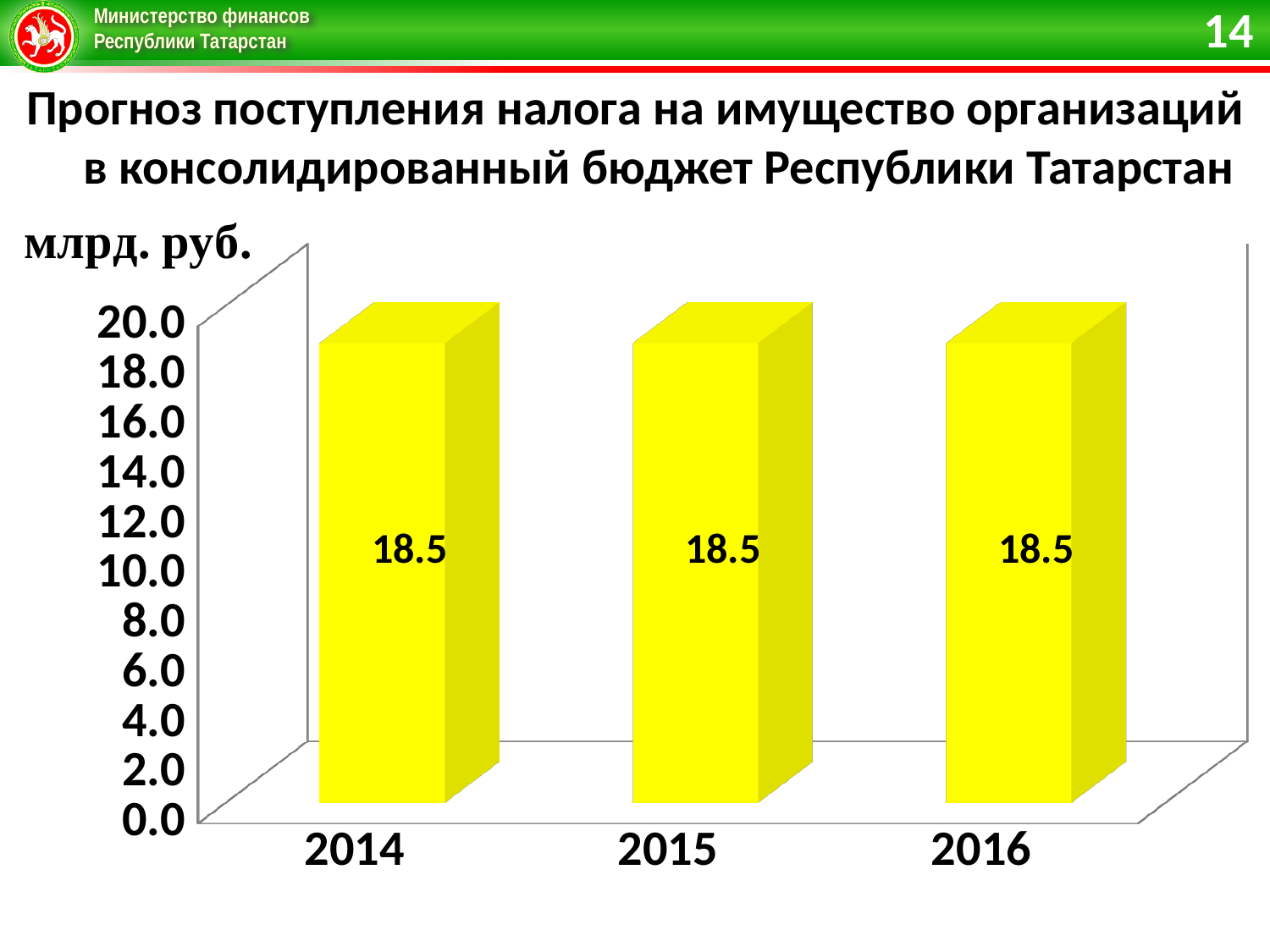
Is the value for 2015 greater or less than 16.0? greater What colour are the bars on the chart? yellow How many years are shown on the x axis? 3 What is the value for 2014? 18.5 What is the value for 2016? 18.5 What is the difference between the values for 2014 and 2016? 0.0 Is the value for 2016 greater or less than 20.0? less Do the values rise, fall or stay the same from 2014 to 2016? stay the same What kind of chart is shown on the slide? bar chart What unit is shown for the values on the chart? млрд. руб. What is the value for 2015? 18.5 What is the highest value shown on the vertical axis? 20.0